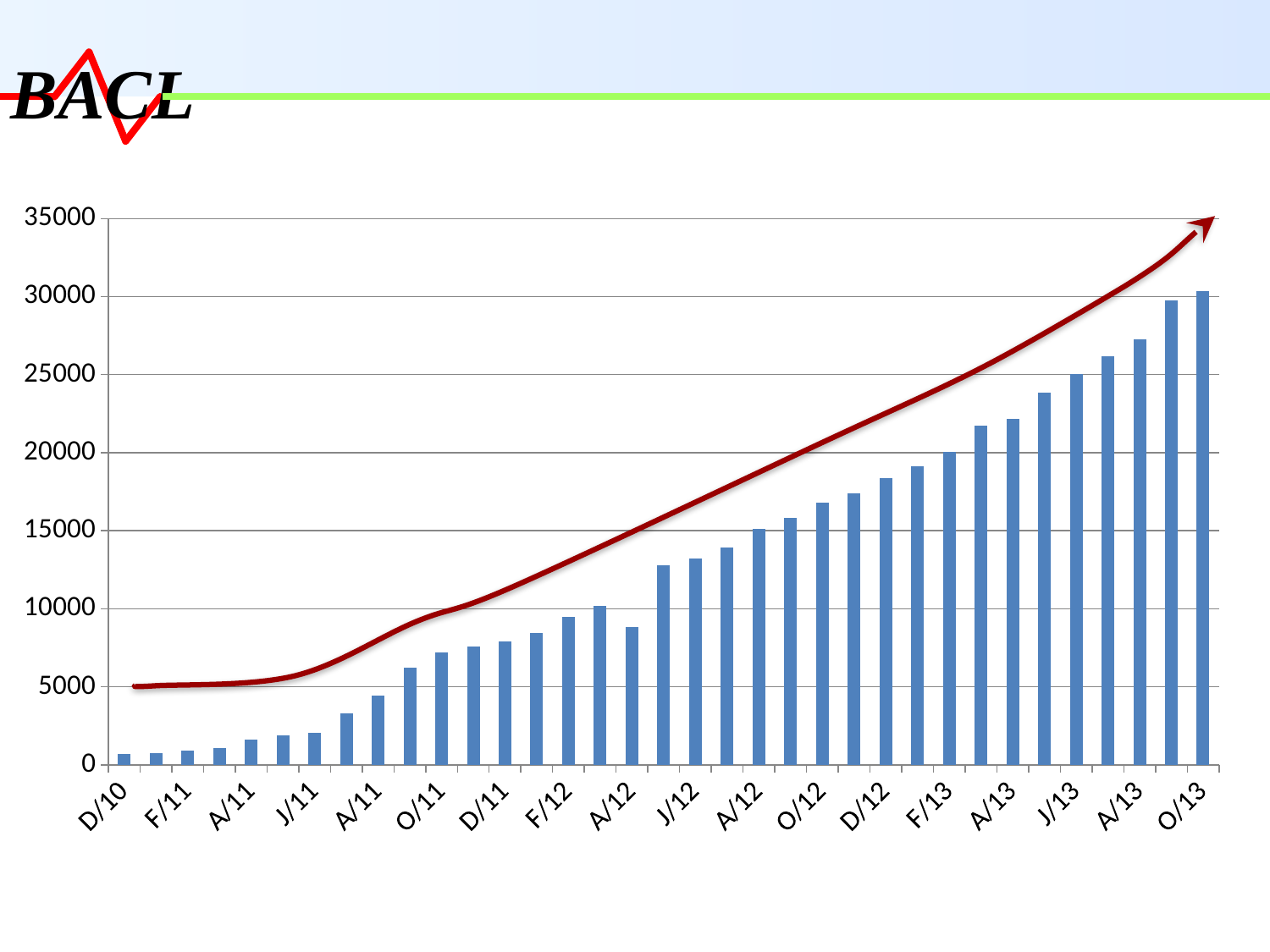
Do the bar values generally rise or fall from D/10 to O/13? rise What colour are the bars in the chart? blue What kind of chart is shown on the slide? bar chart Is the value for O/13 greater or less than 25000? greater Which category has the lowest bar? D/10 Is the value for O/11 greater or less than 5000? greater Is the value for D/12 greater or less than 20000? less Which is larger, the value for J/13 or the value for J/12? J/13 Which category has the highest bar? O/13